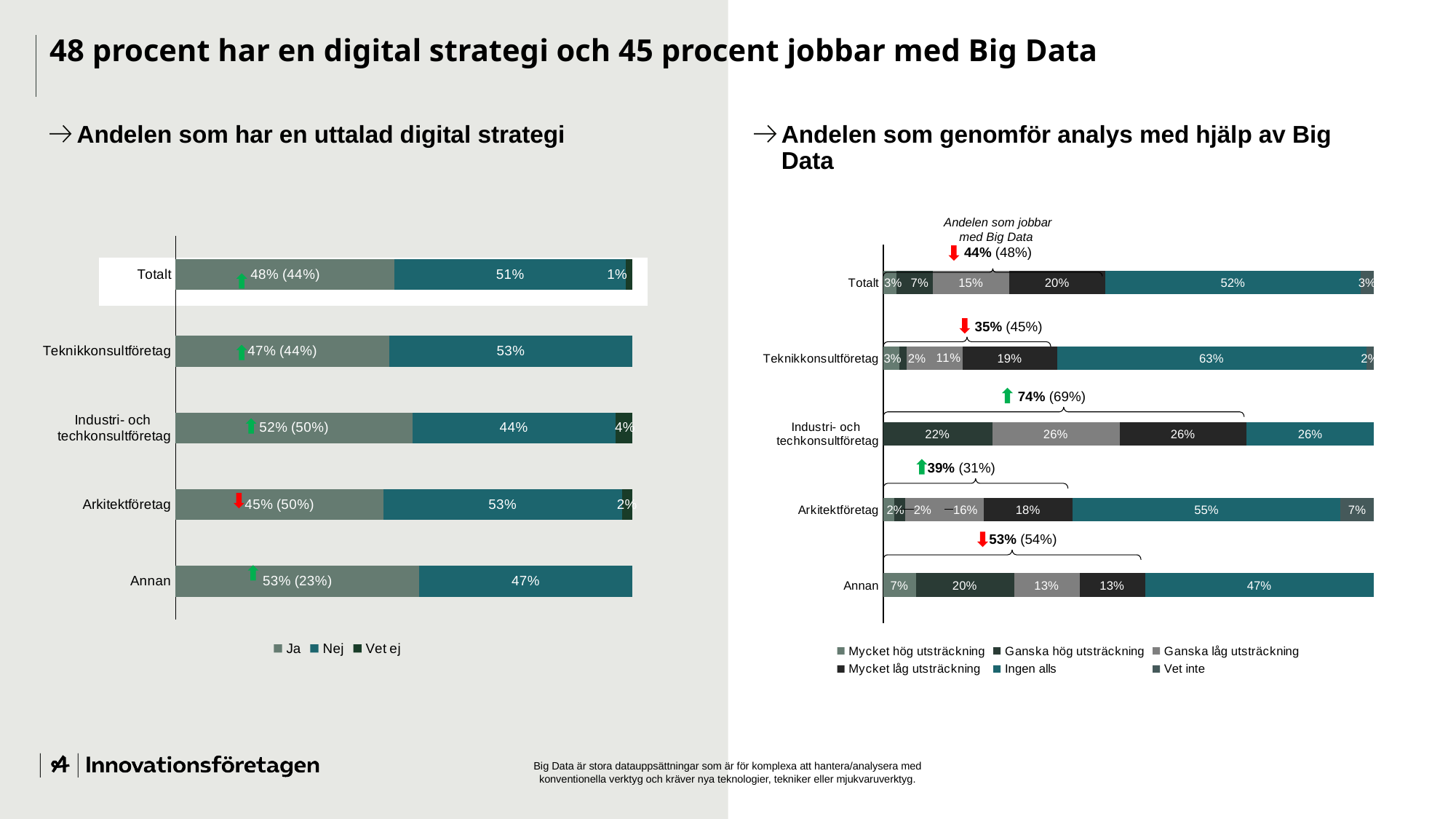
In the left chart (Andelen som har en uttalad digital strategi), which category has the highest 'Nej' value? Teknikkonsultföretag and Arkitektföretag (53%) In the right chart (Andelen som genomför analys med hjälp av Big Data), what is the 'Ingen alls' value for Teknikkonsultföretag? 63% How many categories are shown on the y axis of the right chart (Andelen som genomför analys med hjälp av Big Data)? 5 In the left chart (Andelen som har en uttalad digital strategi), what is the 'Nej' value for Totalt? 51% In the left chart (Andelen som har en uttalad digital strategi), how many series does the legend list? 3 In the right chart (Andelen som genomför analys med hjälp av Big Data), what is the 'Mycket hög utsträckning' value for Annan? 7% What type of chart is the left chart (Andelen som har en uttalad digital strategi)? Stacked bar chart In the right chart (Andelen som genomför analys med hjälp av Big Data), is the 'Ingen alls' value larger for Totalt or for Arkitektföretag? Arkitektföretag In the left chart (Andelen som har en uttalad digital strategi), what is the 'Ja' value for Annan? 53% (23%) In the right chart (Andelen som genomför analys med hjälp av Big Data), which category has the highest 'Ganska hög utsträckning' value? Industri- och techkonsultföretag In the right chart (Andelen som genomför analys med hjälp av Big Data), how many series does the legend list? 6 In the left chart (Andelen som har en uttalad digital strategi), what is the difference between the 'Nej' value and the 'Ja' value for Industri- och techkonsultföretag? 8 percentage points